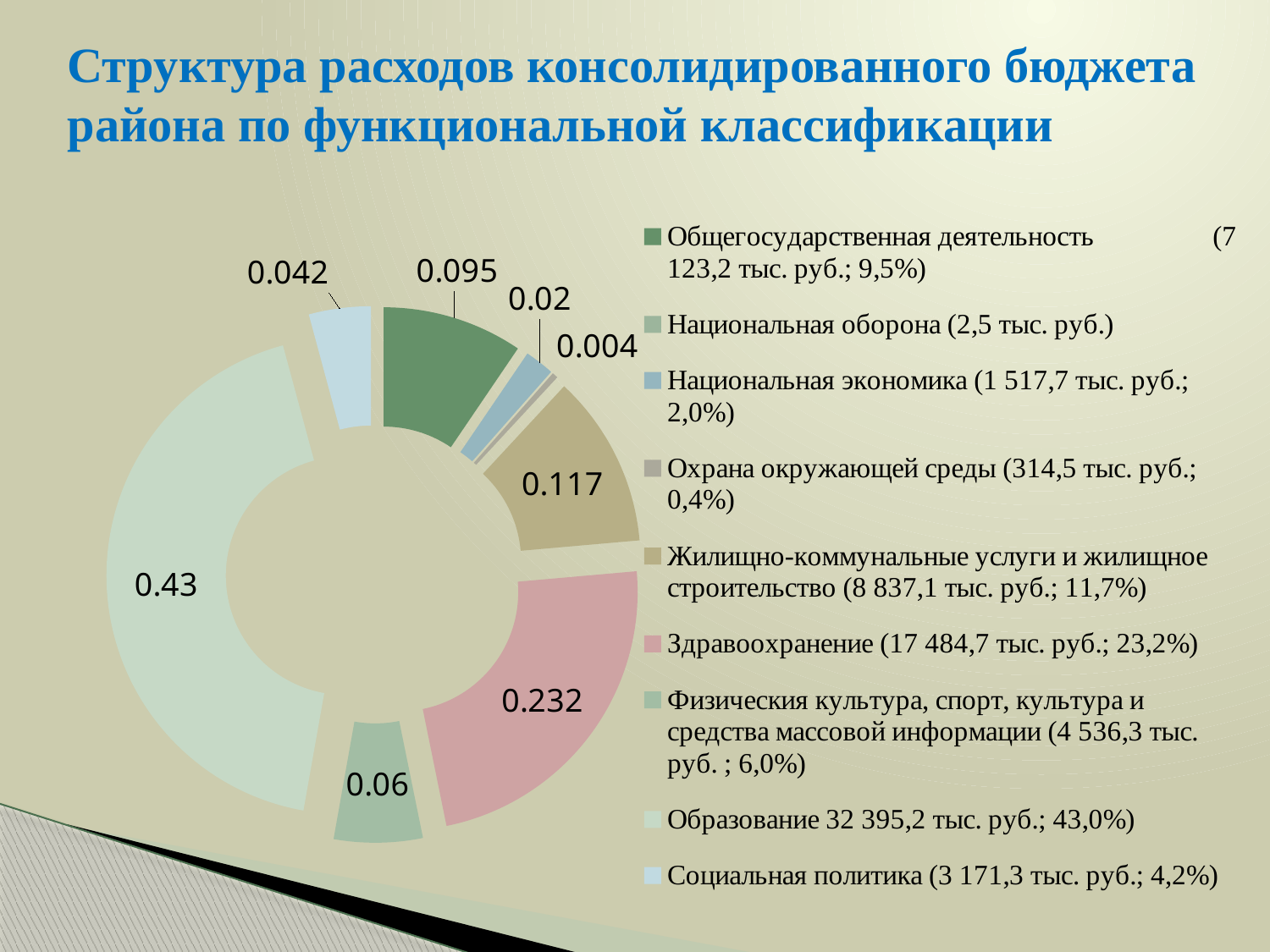
Which slice is larger: Жилищно-коммунальные услуги и жилищное строительство or Общегосударственная деятельность? Жилищно-коммунальные услуги и жилищное строительство What value is labelled on the slice for Здравоохранение? 0.232 What value is labelled on the slice for Физическия культура, спорт, культура и средства массовой информации? 0.06 Which category has the largest slice in the chart? Образование What is the difference between the labelled values for Образование and Здравоохранение? 0.198 What value is labelled on the slice for Социальная политика? 0.042 What kind of chart is shown on the slide? doughnut chart What value is labelled on the slice for Образование? 0.43 According to the legend, what amount in тыс. руб. is given for Образование? 32 395,2 тыс. руб. What is the difference between the labelled values for Здравоохранение and Жилищно-коммунальные услуги и жилищное строительство? 0.115 What value is labelled on the slice for Жилищно-коммунальные услуги и жилищное строительство? 0.117 How many categories does the legend list? 9